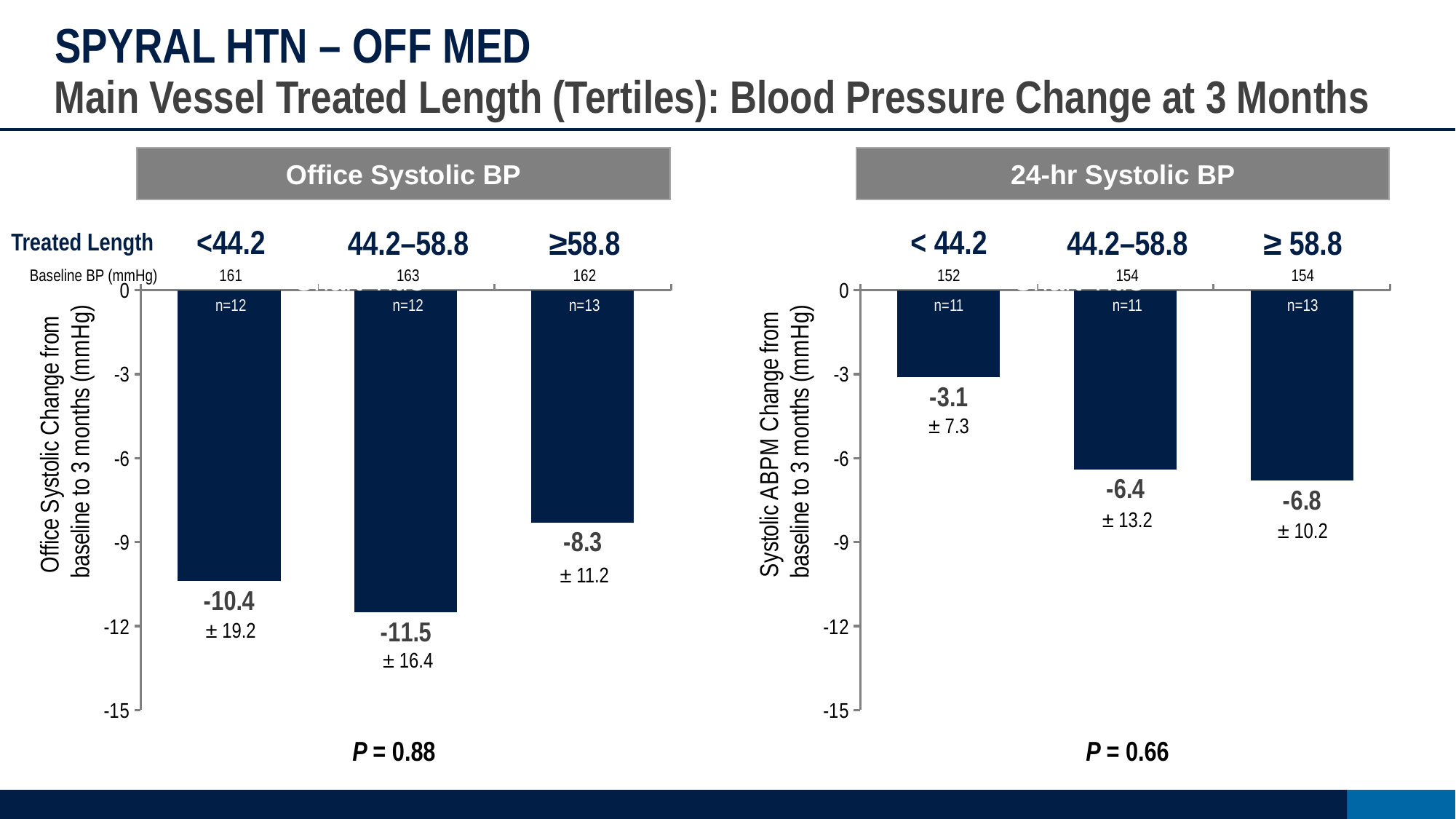
In the 24-hr Systolic BP chart, which group has a larger reduction: 44.2–58.8 or <44.2? 44.2–58.8 In the 24-hr Systolic BP chart, which treated length group shows the smallest reduction in blood pressure? <44.2 What kind of chart is the 24-hr Systolic BP chart? Bar chart What is the P value shown below the Office Systolic BP chart? P = 0.88 How many treated length groups are shown in the Office Systolic BP chart? 3 In the Office Systolic BP chart, what is the change from baseline for the <44.2 treated length group? -10.4 In the Office Systolic BP chart, which treated length group shows the largest reduction in blood pressure? 44.2–58.8 In the 24-hr Systolic BP chart, what is the change from baseline for the <44.2 treated length group? -3.1 In the 24-hr Systolic BP chart, what is the difference between the changes for the ≥58.8 group and the <44.2 group? 3.7 In the 24-hr Systolic BP chart, what is the change from baseline for the ≥58.8 treated length group? -6.8 In the Office Systolic BP chart, what is the difference between the changes for the 44.2–58.8 group and the ≥58.8 group? 3.2 In the Office Systolic BP chart, what is the change from baseline for the 44.2–58.8 treated length group? -11.5